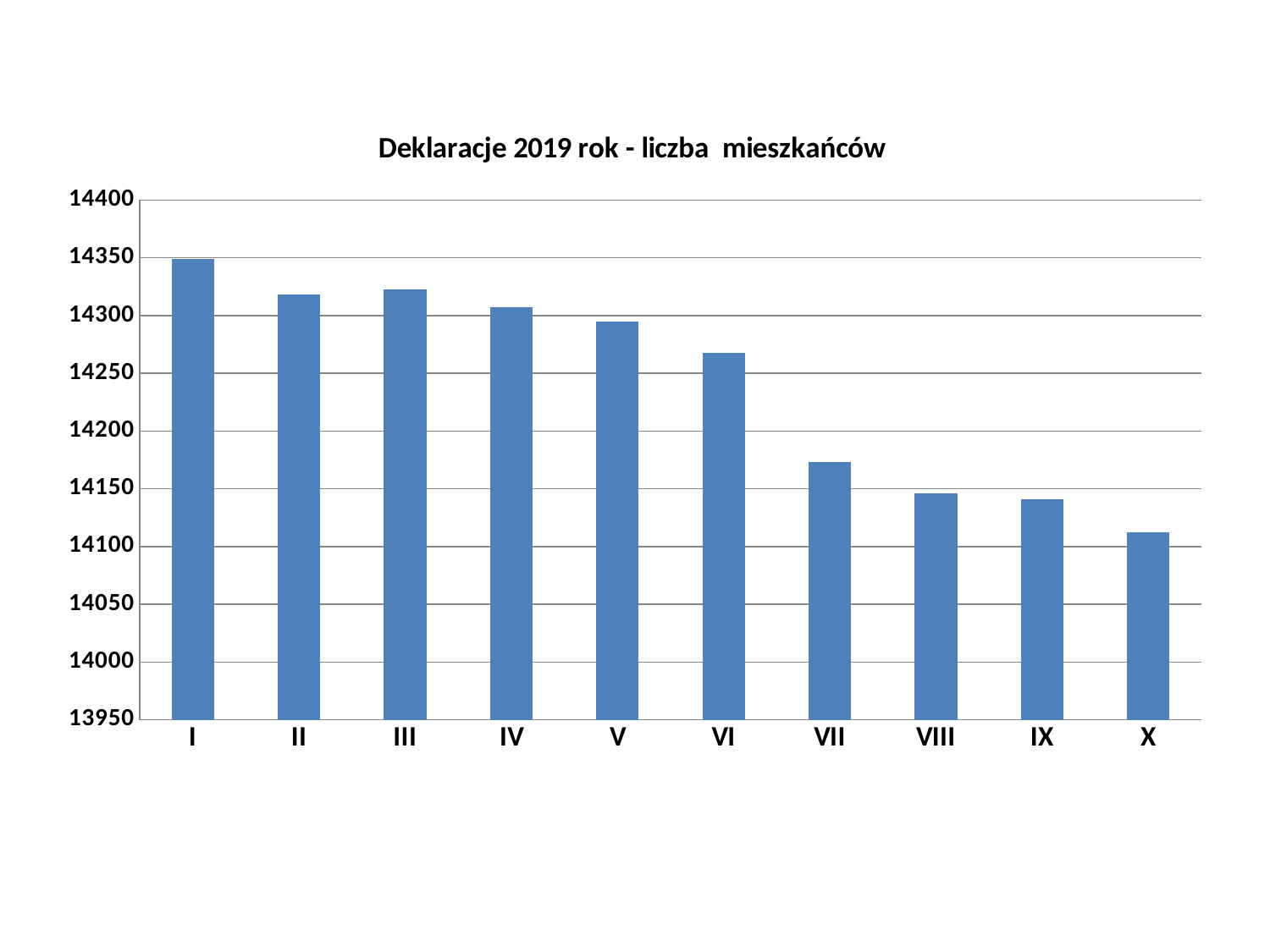
How many categories are shown on the x axis? 10 What type of chart is shown on the slide? bar chart Which category has the highest value? I Which is larger, the value for VI or the value for VII? VI Is the value for VI greater or less than 14250? greater Do the values generally rise or fall from I to X? fall Is the value for I greater or less than 14300? greater Is the value for VII greater or less than 14200? less What colour are the bars in the chart? blue Which category has the lowest value? X What is the title of the chart? Deklaracje 2019 rok - liczba mieszkańców